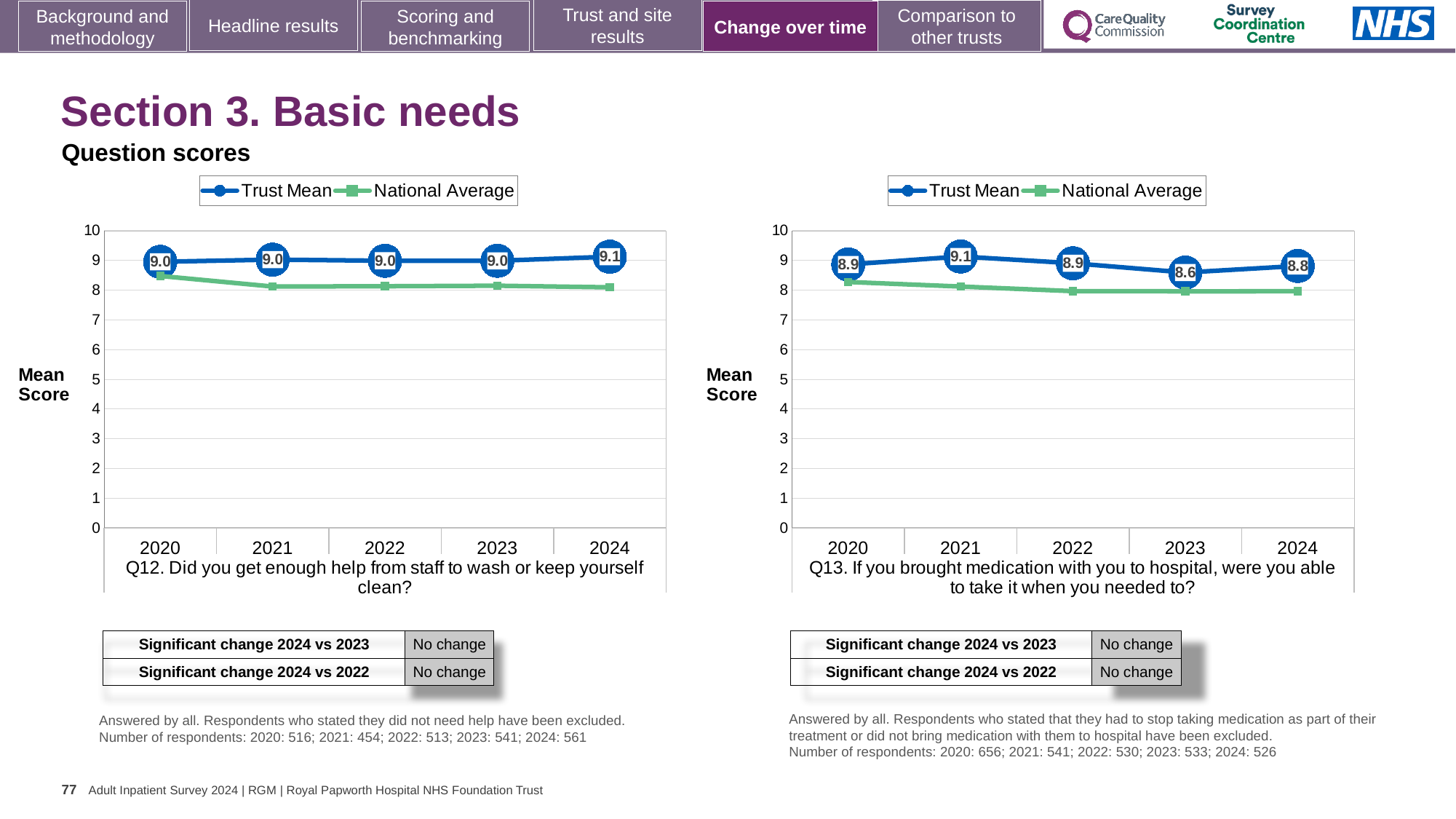
In the Q12 chart (left), is the National Average for 2024 greater or less than 9? less In the Q13 chart (right), which year has the lowest Trust Mean? 2023 In the Q12 chart (left), what is the Trust Mean for 2021? 9.0 In the Q13 chart (right), which year has the highest Trust Mean? 2021 In the Q13 chart (right), what is the Trust Mean for 2021? 9.1 How many series does the legend of the Q13 chart (right) list? 2 In the Q13 chart (right), is the Trust Mean for 2024 larger or smaller than the Trust Mean for 2023? larger How many years are plotted on the x axis of the Q12 chart (left)? 5 What type of chart is the Q12 chart (left)? Line chart In the Q12 chart (left), what is the Trust Mean for 2024? 9.1 In the Q13 chart (right), what is the Trust Mean for 2023? 8.6 In the Q13 chart (right), what is the difference between the Trust Mean for 2021 and 2023? 0.5